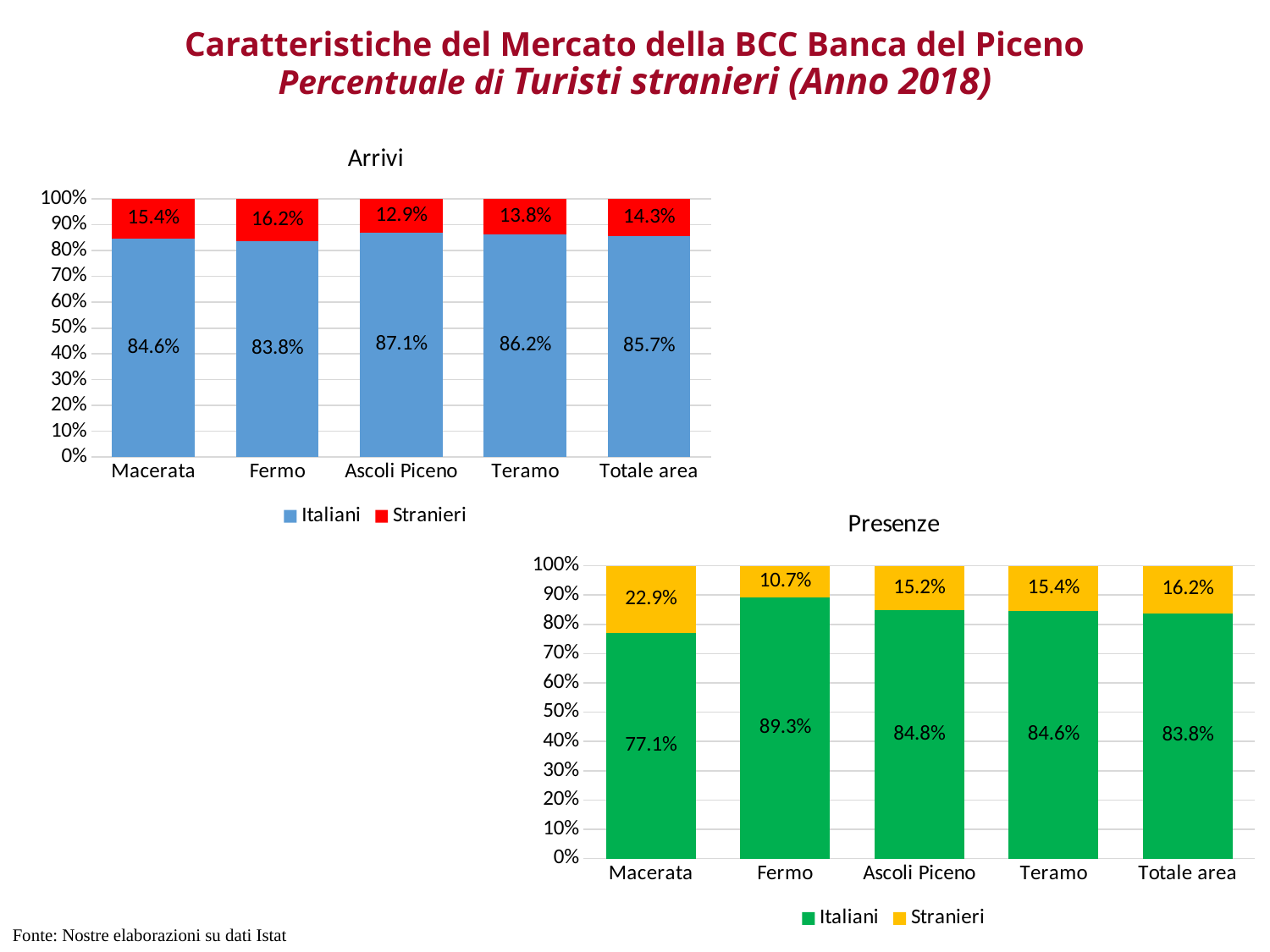
How many series does the legend of the Arrivi chart list? 2 In the Presenze chart, what is the difference between the Stranieri values for Macerata and Fermo? 12.2% How many categories are shown on the x axis of the Presenze chart? 5 In the Arrivi chart, what is the value for Stranieri in Fermo? 16.2% In the Arrivi chart, what is the value for Italiani in Ascoli Piceno? 87.1% In the Arrivi chart, which category has the highest Stranieri share? Fermo In the Presenze chart, which category has the lowest Stranieri share? Fermo In the Presenze chart, what colour represents Stranieri? Yellow In the Presenze chart, what is the value for Italiani in Totale area? 83.8% In the Presenze chart, what is the value for Stranieri in Macerata? 22.9% In the Arrivi chart, which is larger: the Stranieri value for Macerata or for Teramo? Macerata What kind of chart is the Presenze chart? Stacked bar chart